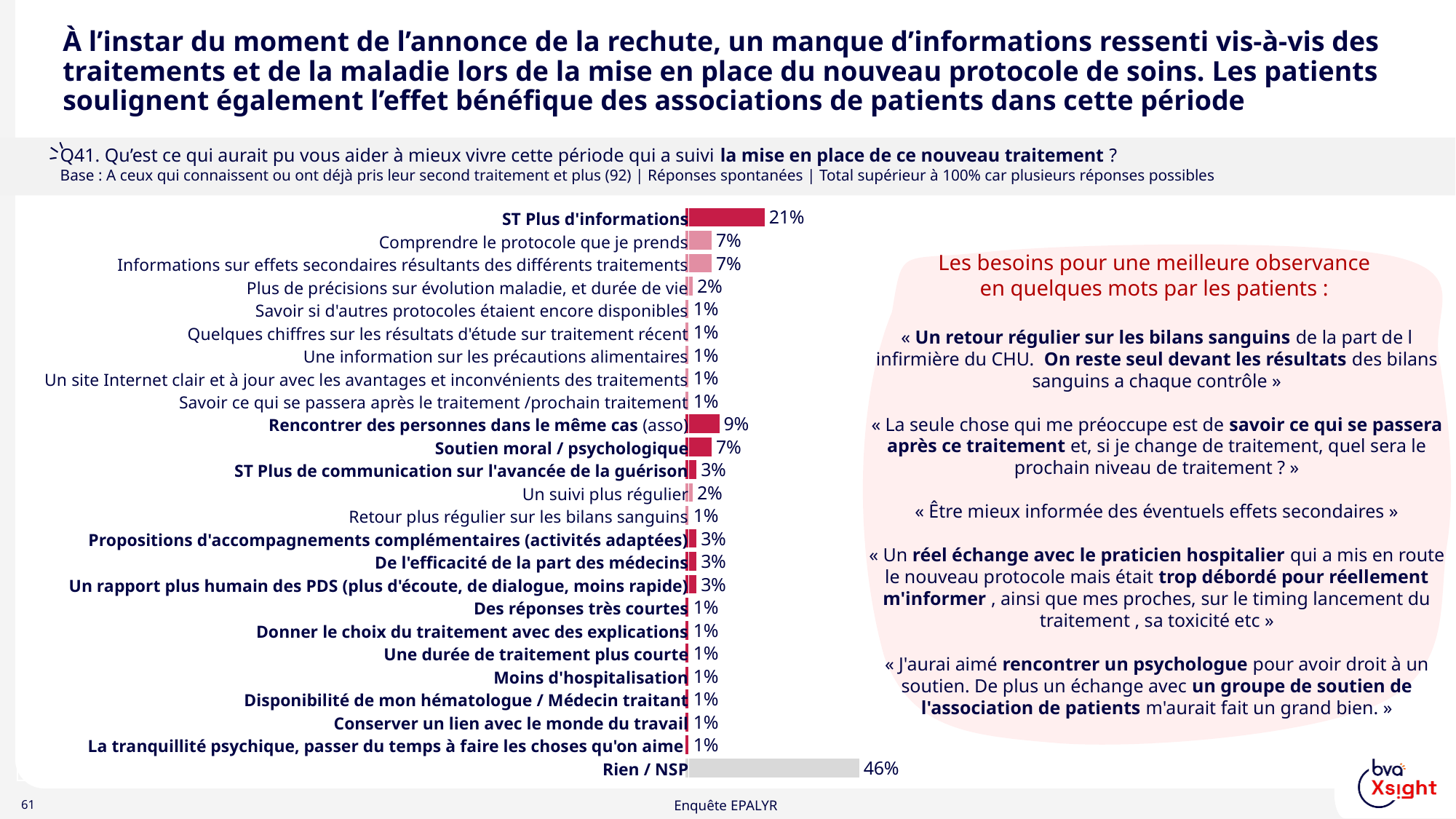
What is the difference between the values for "Rien / NSP" and "ST Plus d'informations"? 25% What value is shown for "Rencontrer des personnes dans le même cas (asso)"? 9% How many categories are plotted in the chart? 25 Which category has the highest value in the chart? Rien / NSP What value is shown for "Rien / NSP"? 46% What kind of chart is shown on the slide? Bar chart What value is shown for "ST Plus d'informations"? 21% What value is shown for "De l'efficacité de la part des médecins"? 3% What value is shown for "Un suivi plus régulier"? 2% What value is shown for "Soutien moral / psychologique"? 7% Which is larger: the value for "Rencontrer des personnes dans le même cas (asso)" or the value for "ST Plus de communication sur l'avancée de la guérison"? Rencontrer des personnes dans le même cas (asso) What is the difference between the values for "ST Plus d'informations" and "Rencontrer des personnes dans le même cas (asso)"? 12%